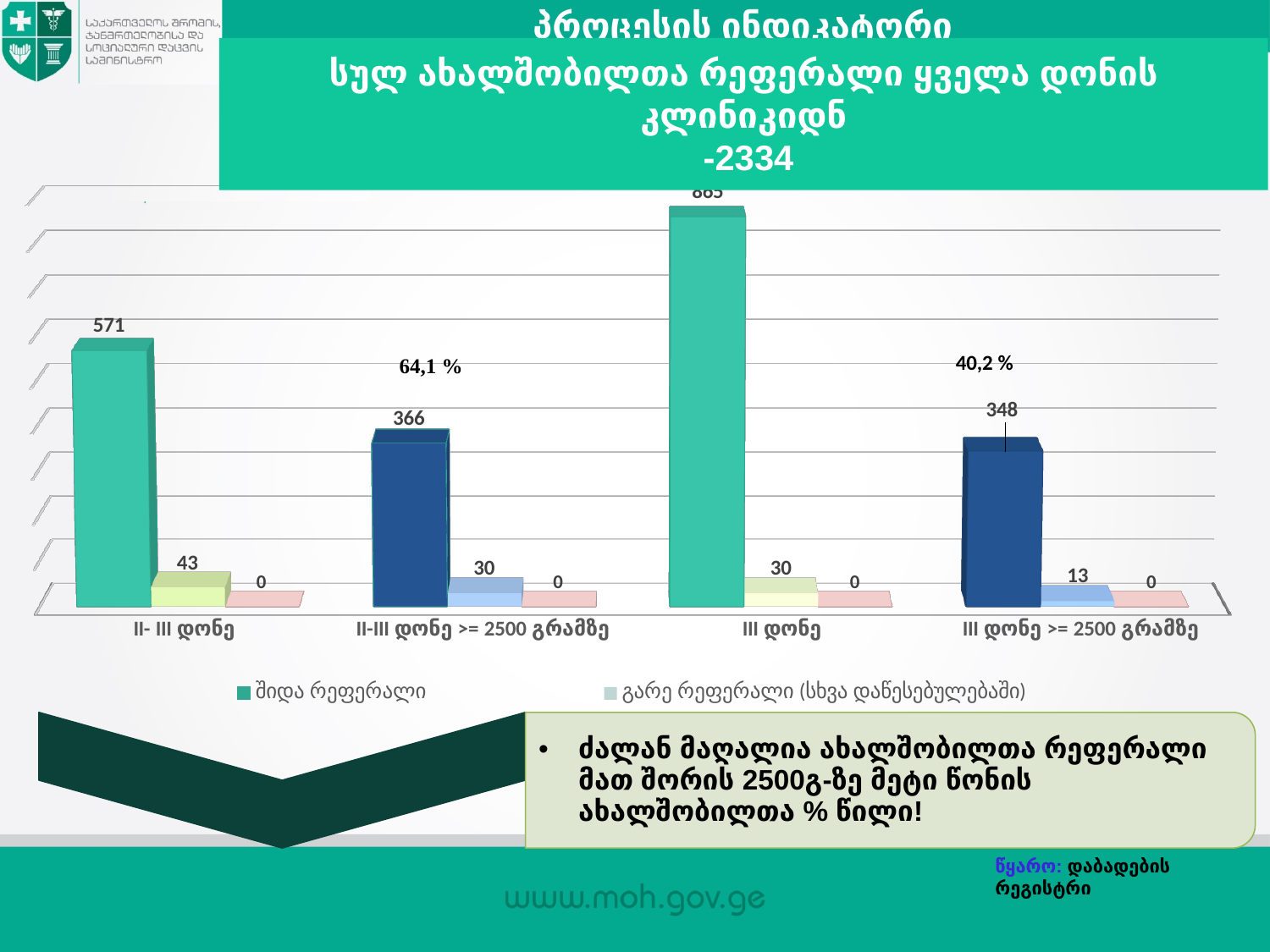
What is the difference between the tallest bars of 'II- III დონე' (571) and 'II-III დონე >= 2500 გრამზე' (366)? 205 What is the value of the tallest bar in the 'II-III დონე >= 2500 გრამზე' category? 366 What percentage label is shown above the 'III დონე >= 2500 გრამზე' category? 40,2 % What type of chart is shown on the slide? bar chart Which category has the tallest bar in the chart? III დონე What is the value of the second (smaller) bar in the 'II- III დონე' category? 43 What is the value of the tallest bar in the 'III დონე >= 2500 გრამზე' category? 348 What is the value of the second (smaller) bar in the 'III დონე >= 2500 გრამზე' category? 13 How many series does the chart legend list? 2 What is the value of the tallest bar in the 'II- III დონე' category? 571 How many categories are shown on the x axis of the chart? 4 Which is larger: the tallest bar for 'II-III დონე >= 2500 გრამზე' or the tallest bar for 'III დონე >= 2500 გრამზე'? II-III დონე >= 2500 გრამზე